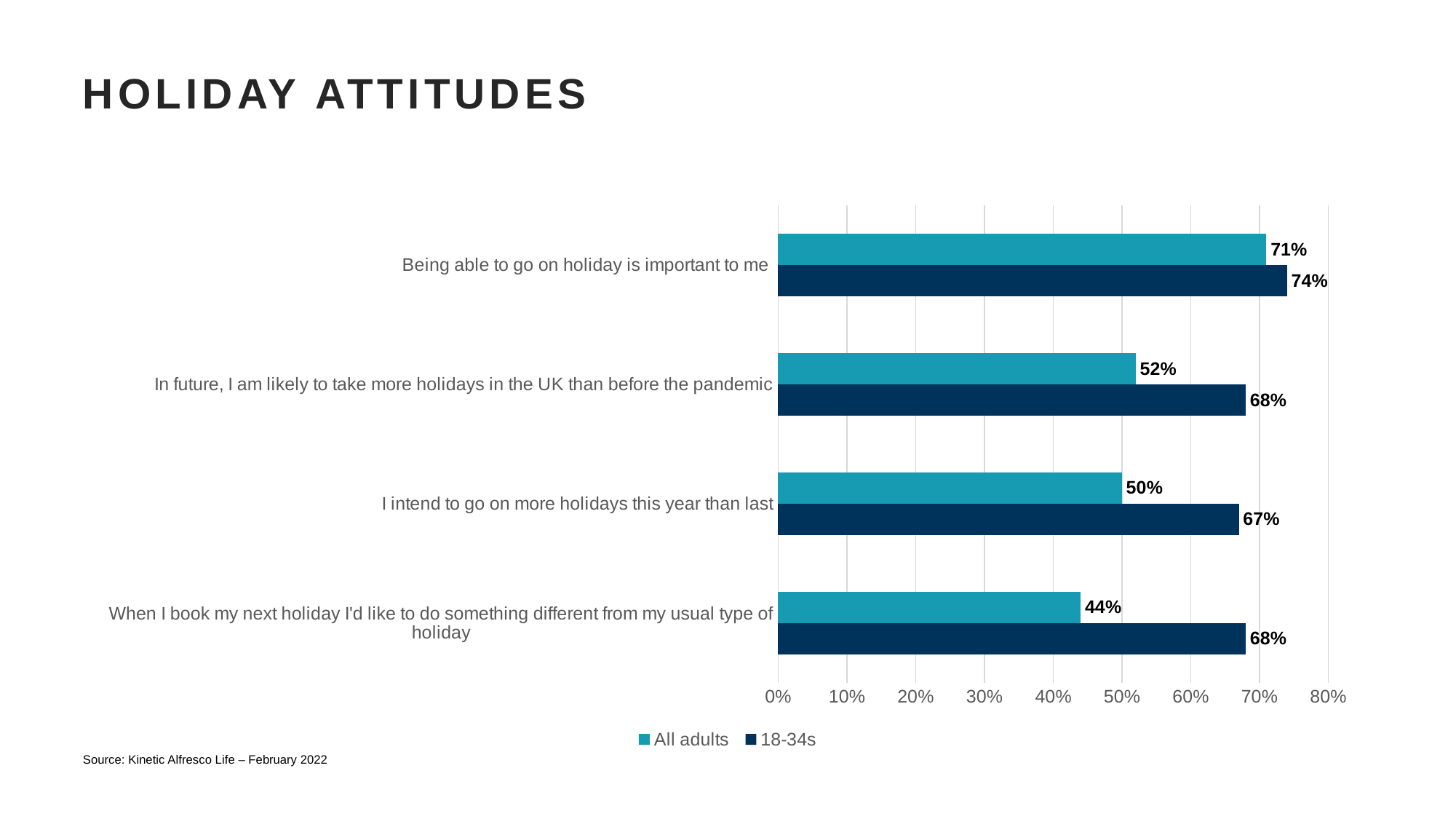
What percentage of 18-34s say they are likely to take more holidays in the UK than before the pandemic? 68% For 'I intend to go on more holidays this year than last', which group has the higher value: all adults or 18-34s? 18-34s What percentage of all adults would like to do something different from their usual type of holiday when booking their next holiday? 44% What is the source cited for the chart? Kinetic Alfresco Life – February 2022 How many statements are shown on the chart? 4 What percentage of all adults agree that being able to go on holiday is important to them? 71% What type of chart is shown on the slide? Bar chart How many series does the legend list? 2 Which statement has the highest agreement among all adults? Being able to go on holiday is important to me Which statement has the lowest agreement among all adults? When I book my next holiday I'd like to do something different from my usual type of holiday What is the difference between 18-34s and all adults for 'When I book my next holiday I'd like to do something different from my usual type of holiday'? 24% What percentage of 18-34s intend to go on more holidays this year than last? 67%